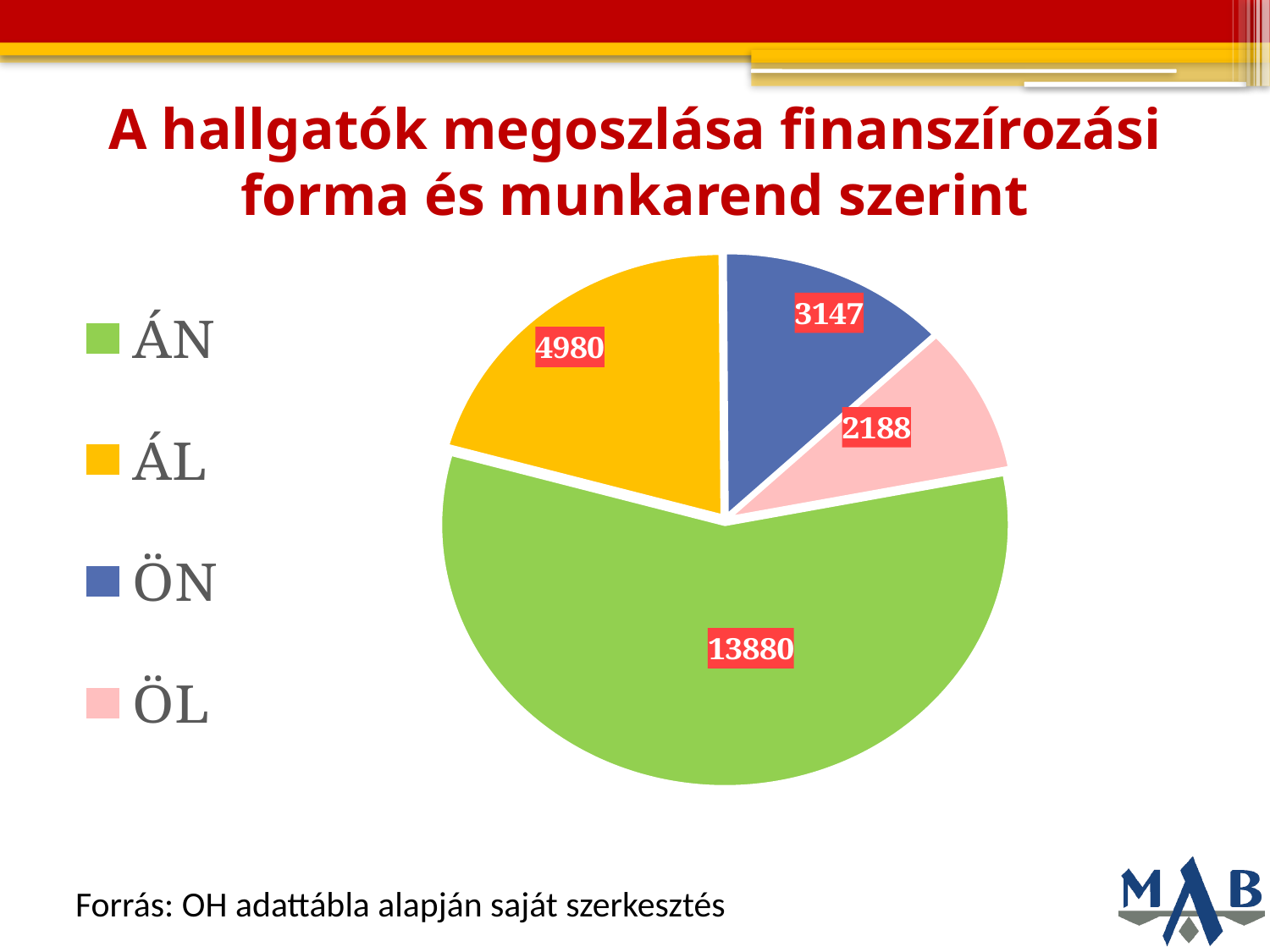
What value is shown for the ÖL slice of the pie chart? 2188 What value is shown for the ÁN slice of the pie chart? 13880 What value is shown for the ÁL slice of the pie chart? 4980 What is the difference between the ÁN value and the ÁL value? 8900 Which category has the smallest slice in the pie chart? ÖL What colour is the ÁN slice in the pie chart? green How many categories does the pie chart show? 4 What value is shown for the ÖN slice of the pie chart? 3147 What is the difference between the ÖN value and the ÖL value? 959 Which category has the largest slice in the pie chart? ÁN Which is larger, the value for ÁL or the value for ÖN? ÁL What type of chart is shown on the slide? pie chart